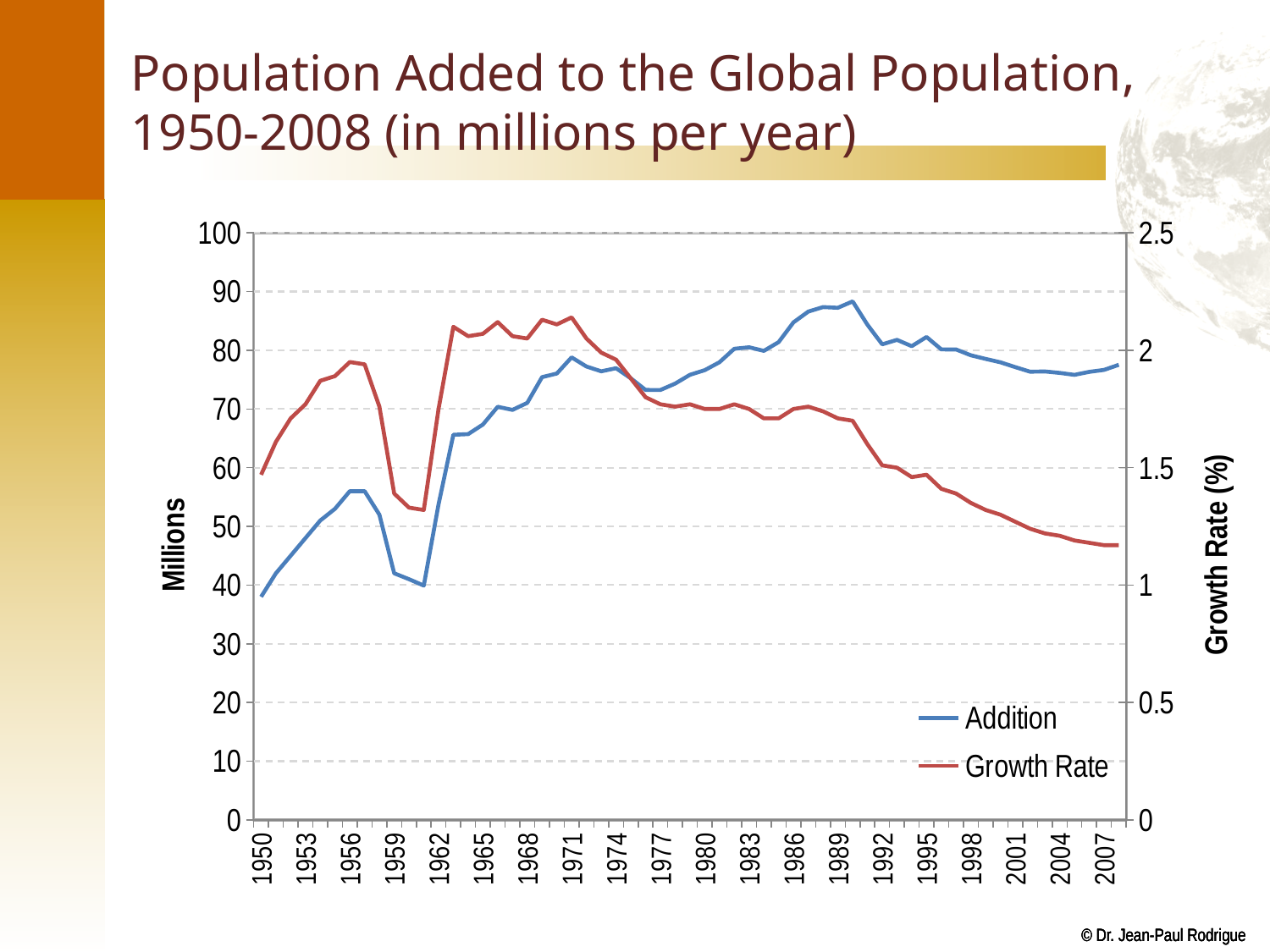
Is the Addition value for 1961 greater or less than 50? less Which is larger, the Addition value in 1962 or in 1989? 1989 Does the Growth Rate line rise or fall between 1990 and 2007? fall Is the Growth Rate value for 2007 greater or less than 1.5? less What is the label of the right-hand vertical axis? Growth Rate (%) Which is larger, the Growth Rate value in 1956 or in 2007? 1956 Is the Growth Rate value for 1971 greater or less than 2? greater How many series does the legend list? 2 What kind of chart is shown on the slide? line chart What are the two series named in the legend? Addition and Growth Rate